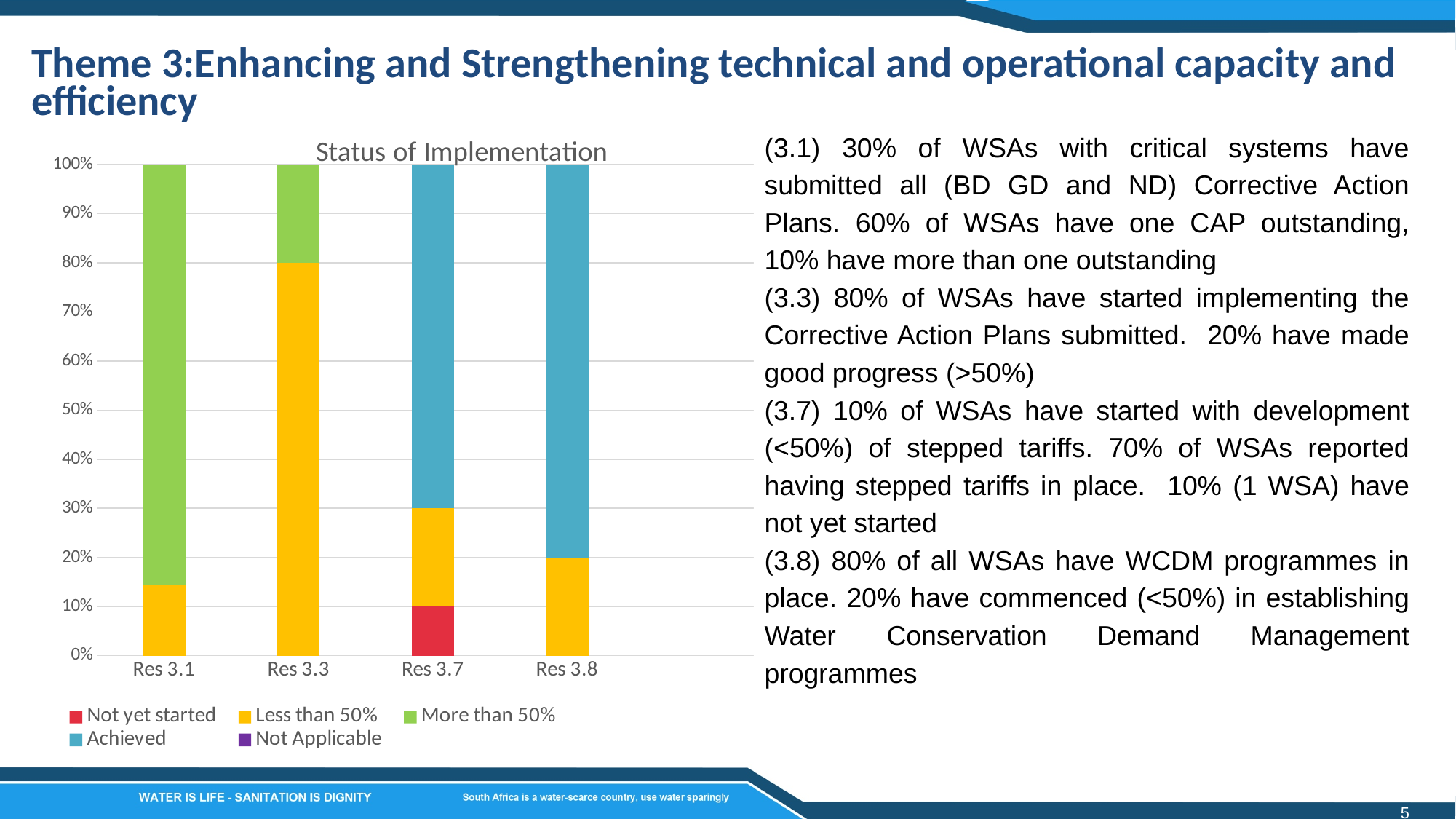
What is the 'Less than 50%' value for Res 3.3? 80% Which category is the only one with a 'Not yet started' segment? Res 3.7 What type of chart is shown on the slide? Stacked bar chart What is the 'Less than 50%' value for Res 3.8? 20% What is the 'Not yet started' value for Res 3.7? 10% How many categories are shown on the x axis of the chart? 4 How many series does the chart legend list? 5 What is the title of the chart? Status of Implementation Is the 'More than 50%' value for Res 3.1 greater or less than 80%? greater Is the 'Achieved' value for Res 3.7 greater or less than 60%? greater Is the 'Less than 50%' value for Res 3.1 greater or less than 20%? less Which category has the larger 'Less than 50%' share, Res 3.3 or Res 3.8? Res 3.3